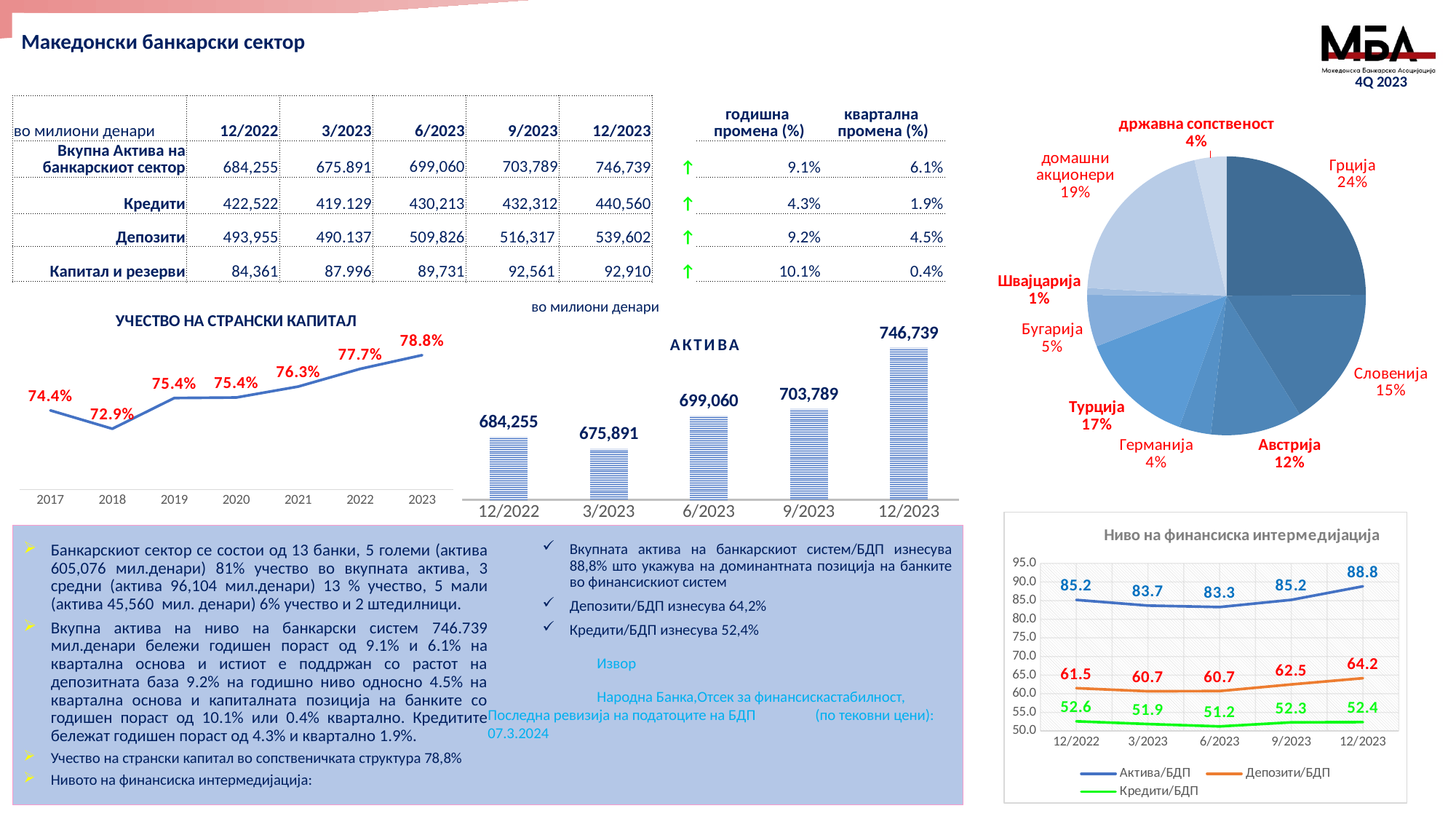
In the 'УЧЕСТВО НА СТРАНСКИ КАПИТАЛ' line chart, which year has the lowest value? 2018 In the 'АКТИВА' bar chart, what is the value for 6/2023? 699,060 In the pie chart on the right, what share does Грција have? 24% In the 'УЧЕСТВО НА СТРАНСКИ КАПИТАЛ' line chart, what is the value for 2023? 78.8% In the 'АКТИВА' bar chart, which period has the highest value? 12/2023 What kind of chart is the 'АКТИВА' chart? Bar chart In the 'Ниво на финансиска интермедијација' chart, what is the value of Депозити/БДП for 12/2023? 64.2 In the pie chart on the right, which slice is the smallest? Швајцарија In the 'УЧЕСТВО НА СТРАНСКИ КАПИТАЛ' line chart, how many years are plotted? 7 How many series does the legend of the 'Ниво на финансиска интермедијација' chart list? 3 In the 'АКТИВА' bar chart, what is the difference between the values for 12/2023 and 9/2023? 42,950